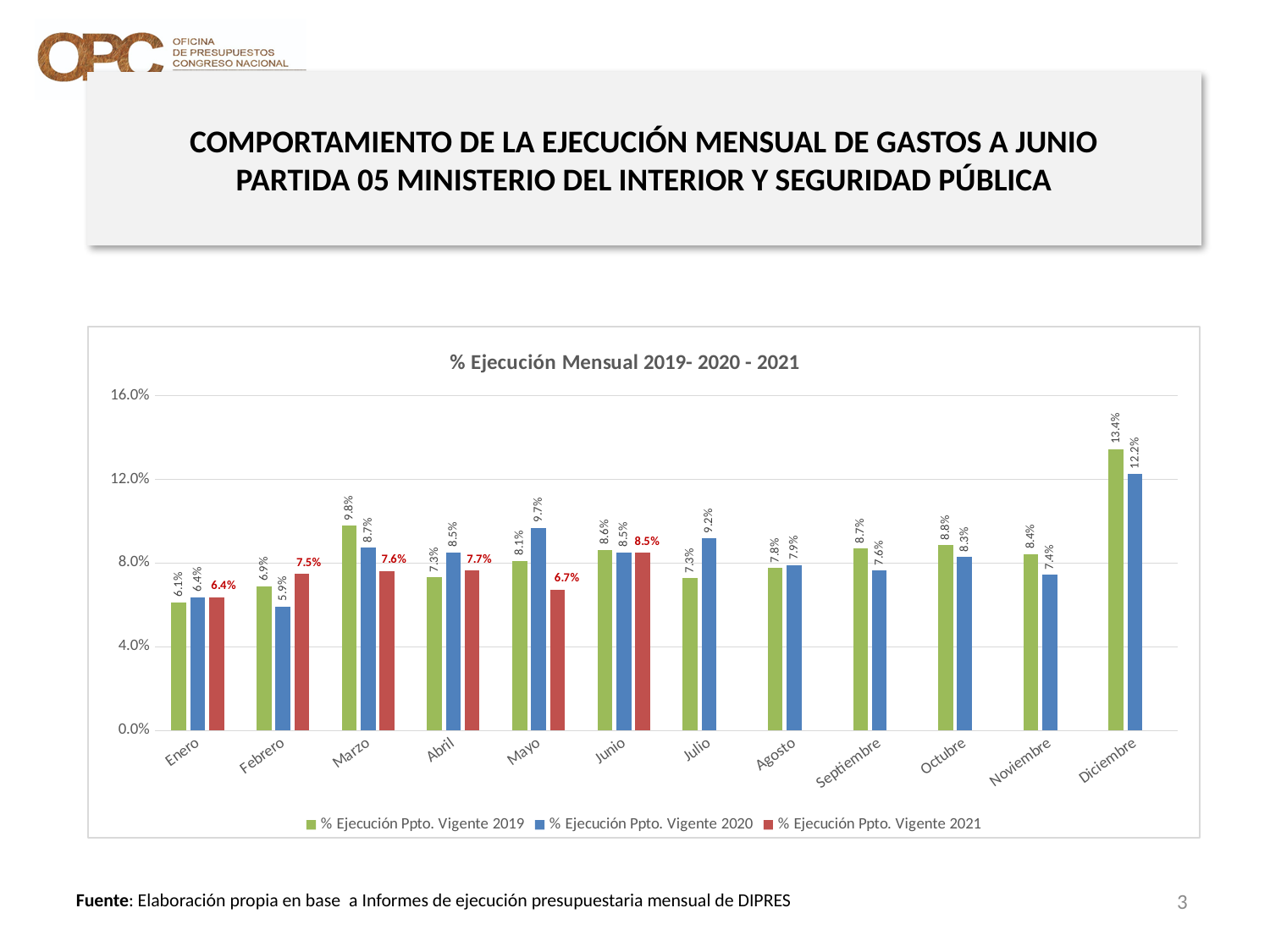
In which month is the % Ejecución Ppto. Vigente 2020 series lowest? Febrero What kind of chart is shown on the slide? Bar chart Is the value for % Ejecución Ppto. Vigente 2019 in Diciembre greater or less than 12.0%? greater What is the difference between the 2019 and 2020 values in Diciembre? 1.2% What is the value for % Ejecución Ppto. Vigente 2019 in Septiembre? 8.7% What is the title of the chart? % Ejecución Mensual 2019- 2020 - 2021 Which is larger in Mayo: the 2020 value or the 2021 value? 2020 value (9.7%) How many months are shown on the x axis? 12 What is the value for % Ejecución Ppto. Vigente 2020 in Diciembre? 12.2% In which month is the % Ejecución Ppto. Vigente 2019 series highest? Diciembre How many series does the legend list? 3 What is the value for % Ejecución Ppto. Vigente 2021 in Marzo? 7.6%